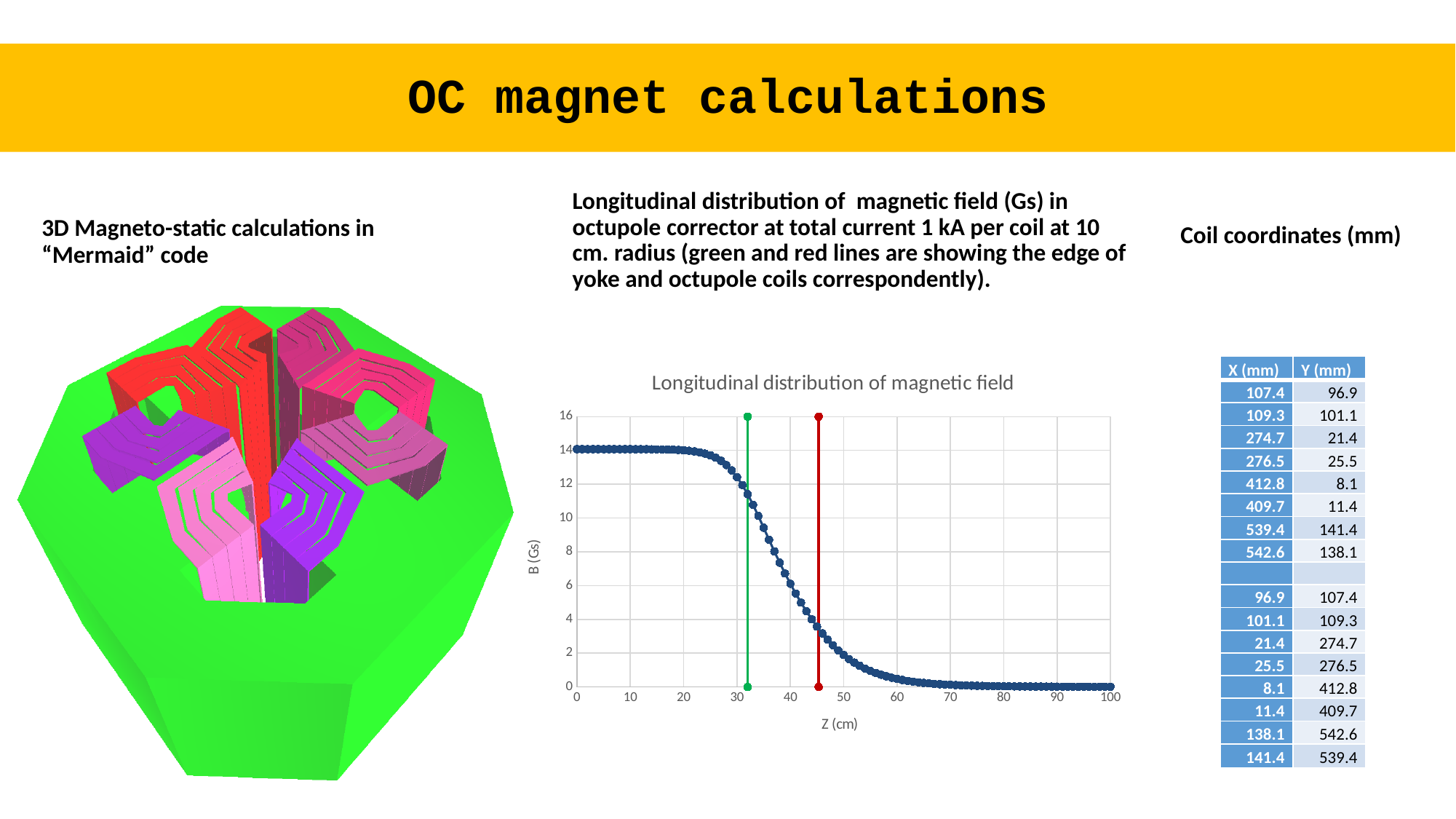
What kind of chart is the 'Longitudinal distribution of magnetic field' chart? scatter chart On the 'Longitudinal distribution of magnetic field' chart, is the value at Z = 50 cm greater or less than 4? less On the 'Longitudinal distribution of magnetic field' chart, is the value at Z = 20 cm greater or less than 12? greater What is the label of the y axis on the 'Longitudinal distribution of magnetic field' chart? B (Gs) On the 'Longitudinal distribution of magnetic field' chart, do the plotted values rise or fall as Z increases? fall On the 'Longitudinal distribution of magnetic field' chart, is the value at Z = 60 cm greater or less than 4? less On the 'Longitudinal distribution of magnetic field' chart, is the value at Z = 20 cm larger or smaller than the value at Z = 60 cm? larger What is the title of the chart in the middle of the slide? Longitudinal distribution of magnetic field What is the highest tick value shown on the y axis of the 'Longitudinal distribution of magnetic field' chart? 16